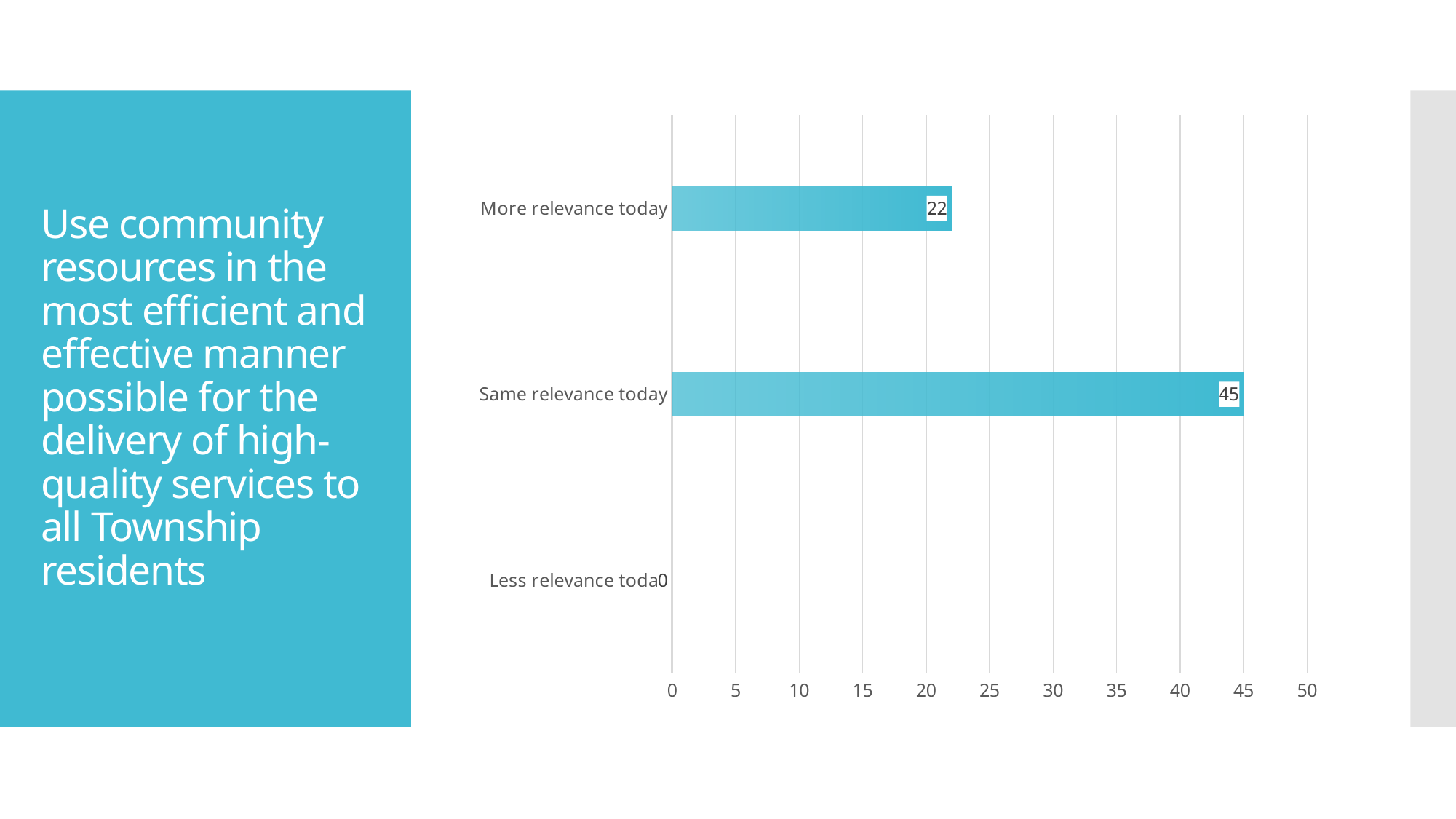
What is the highest value shown on the horizontal axis? 50 What is the difference between the values for "Same relevance today" and "More relevance today"? 23 What is the value for "More relevance today"? 22 Is the value for "Same relevance today" greater or less than 40? greater Which is larger, the value for "More relevance today" or "Same relevance today"? Same relevance today What kind of chart is shown on the slide? bar chart Which category has the highest value? Same relevance today What is the value for "Same relevance today"? 45 Which category has the lowest value? Less relevance today What is the value for "Less relevance today"? 0 How many categories are shown in the chart? 3 Is the value for "More relevance today" greater or less than 25? less